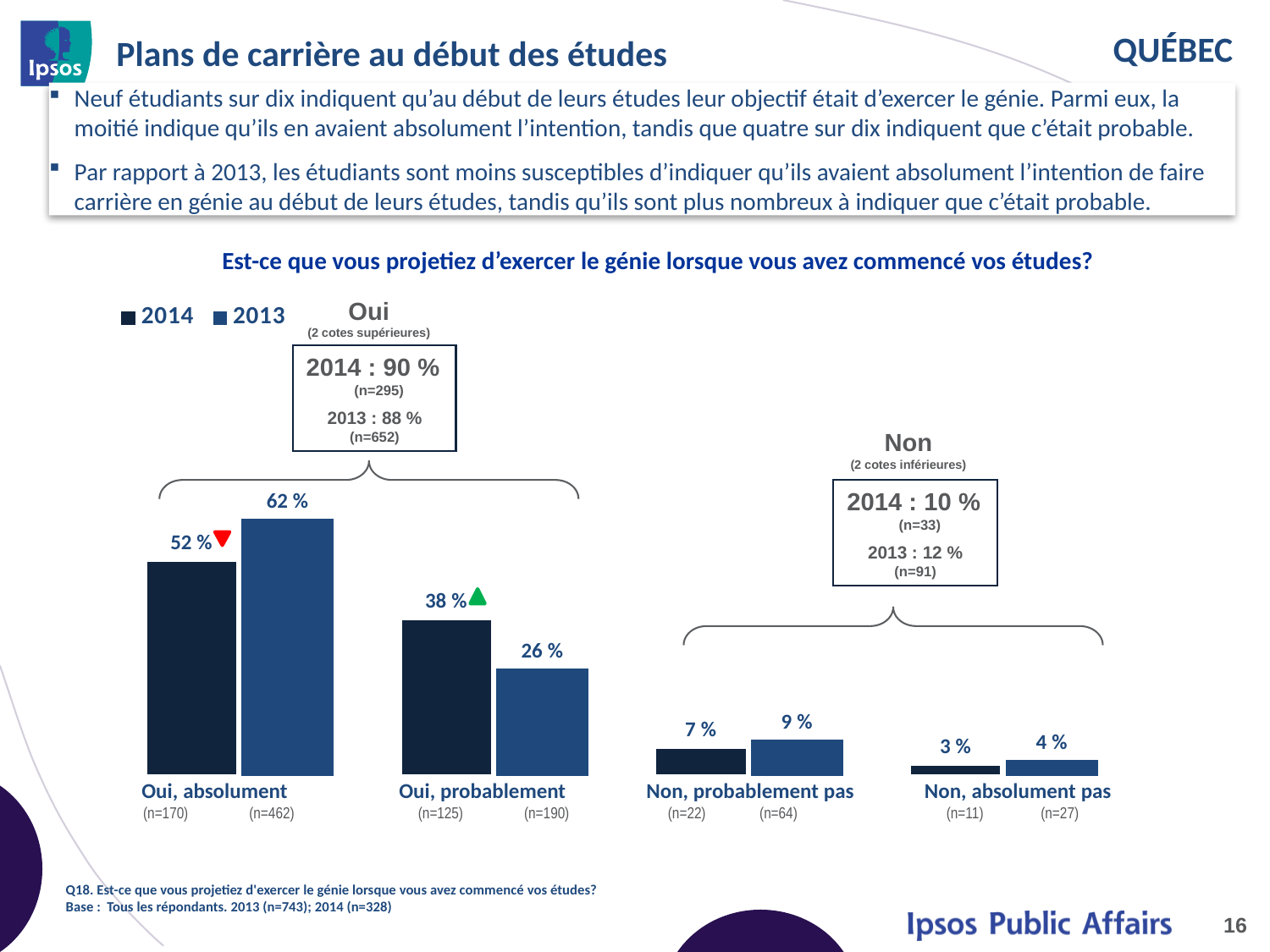
What is the 2013 value for "Oui, probablement"? 26 % What is the 2014 value for "Non, absolument pas"? 3 % How many series does the legend list? 2 Which category has the lowest 2014 value? Non, absolument pas What is the difference between the 2014 and 2013 values for "Oui, probablement"? 12 % Which category has the highest 2013 value? Oui, absolument What is the difference between the 2013 and 2014 values for "Oui, absolument"? 10 % What is the 2013 value for "Non, probablement pas"? 9 % What kind of chart is shown on the slide? Bar chart How many categories are shown on the x axis of the chart? 4 What is the 2014 value for "Oui, absolument"? 52 % For "Oui, probablement", which year has the larger value, 2014 or 2013? 2014